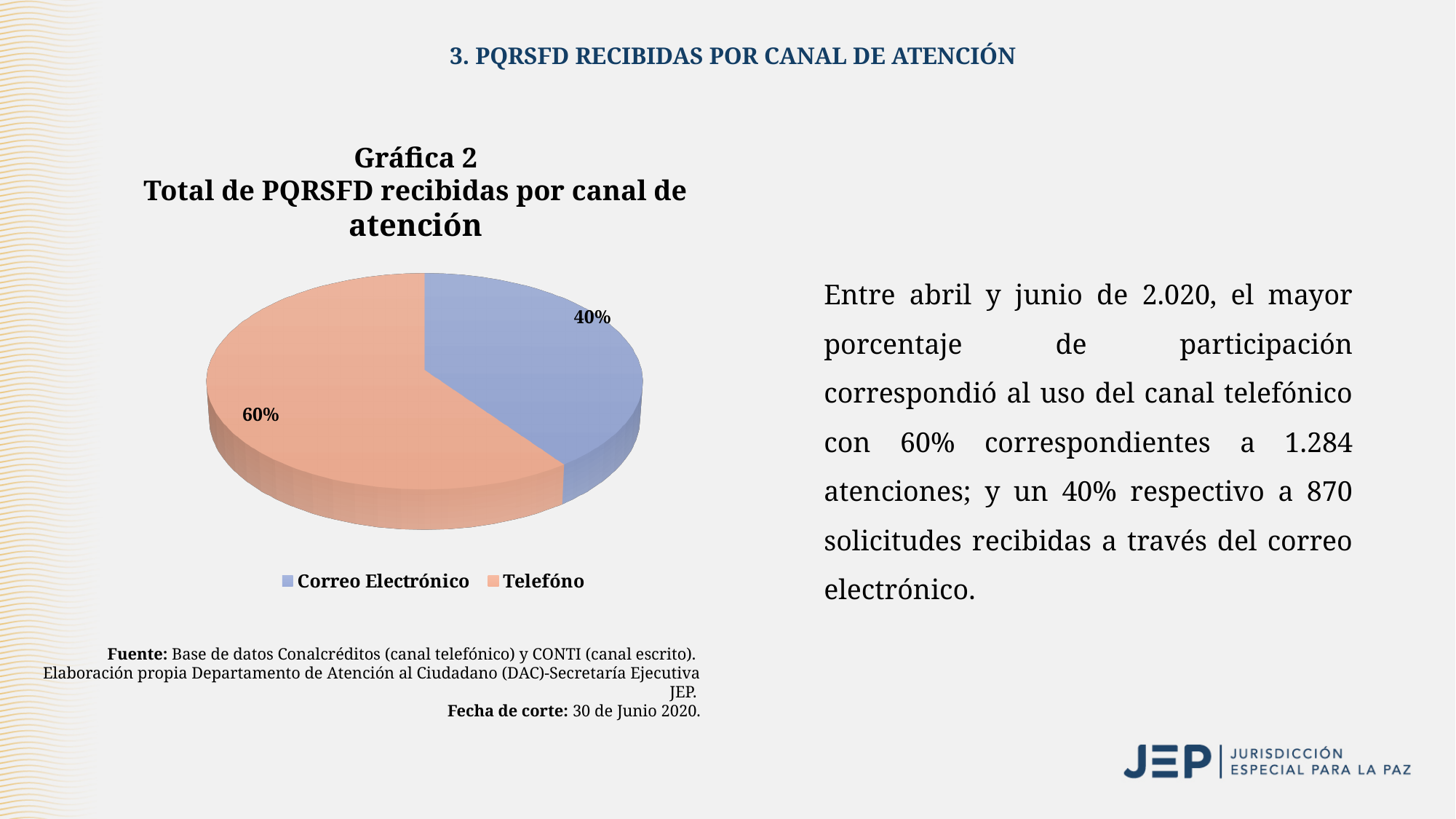
How many entries does the legend list? 2 How many categories are shown in the pie chart? 2 Which channel has the largest share of PQRSFD received? Telefóno Which channel has the smallest share of PQRSFD received? Correo Electrónico What is the title of the chart? Gráfica 2 Total de PQRSFD recibidas por canal de atención Which is larger, the share for Correo Electrónico or the share for Telefóno? Telefóno What share of the pie does Telefóno represent? 60% What kind of chart is shown on the slide? Pie chart What share of the pie does Correo Electrónico represent? 40% What colour is the Telefóno slice in the pie chart? Orange What is the difference in percentage points between the Telefóno and Correo Electrónico shares? 20%